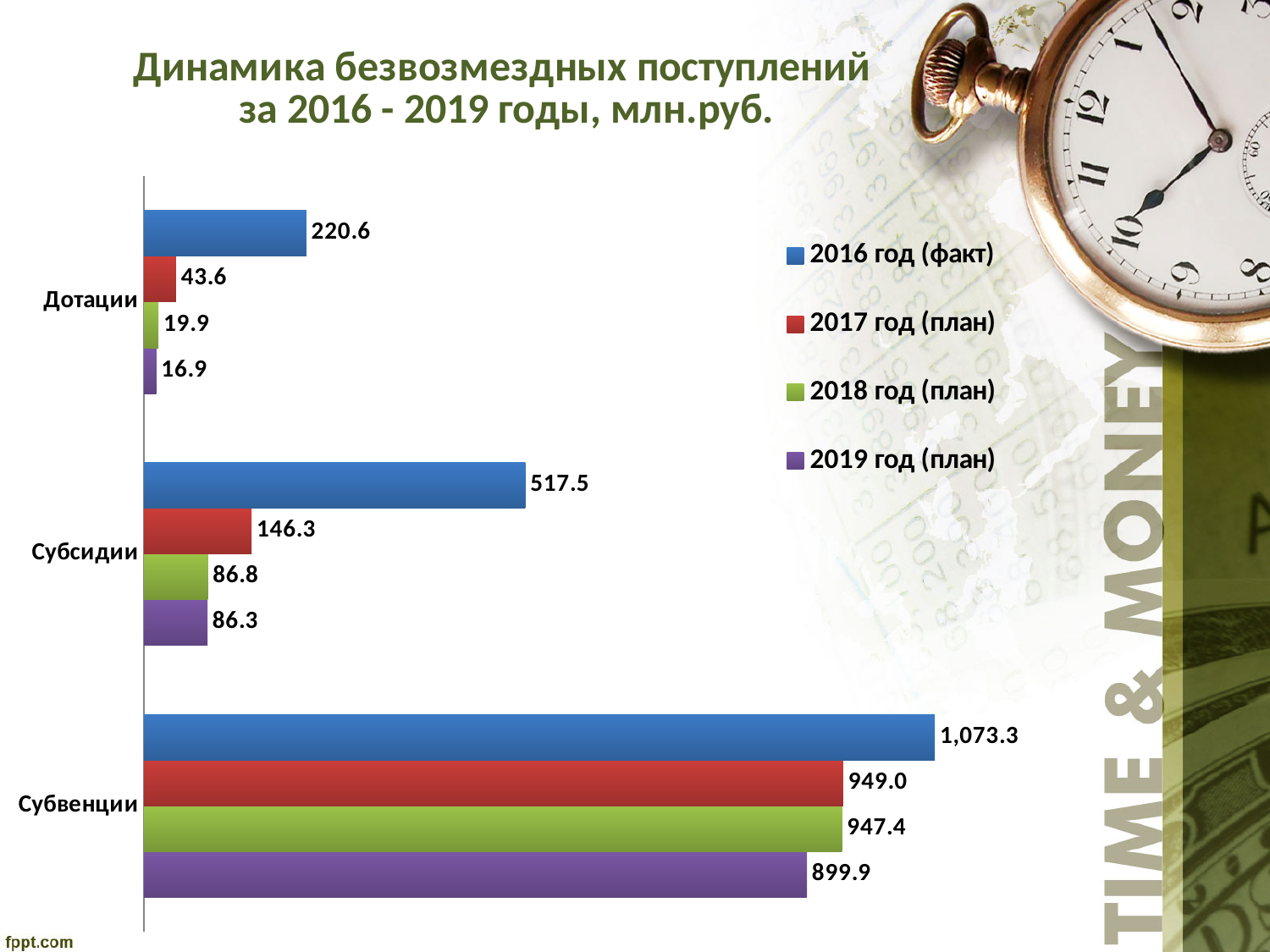
Which category has the lowest value in 2016 год (факт)? Дотации Which category has the highest value in 2018 год (план)? Субвенции What is the value for Субсидии in 2017 год (план)? 146.3 What is the difference between the 2016 год (факт) and 2017 год (план) values for Субсидии? 371.2 What is the title of the chart? Динамика безвозмездных поступлений за 2016 - 2019 годы, млн.руб. What is the value for Дотации in 2019 год (план)? 16.9 What is the difference between the 2018 год (план) and 2019 год (план) values for Субвенции? 47.5 How many series does the legend list? 4 How many categories are shown on the chart? 3 What is the value for Субвенции in 2016 год (факт)? 1,073.3 Which is larger for Дотации: the 2017 год (план) value or the 2018 год (план) value? 2017 год (план) What kind of chart is shown on the slide? Bar chart